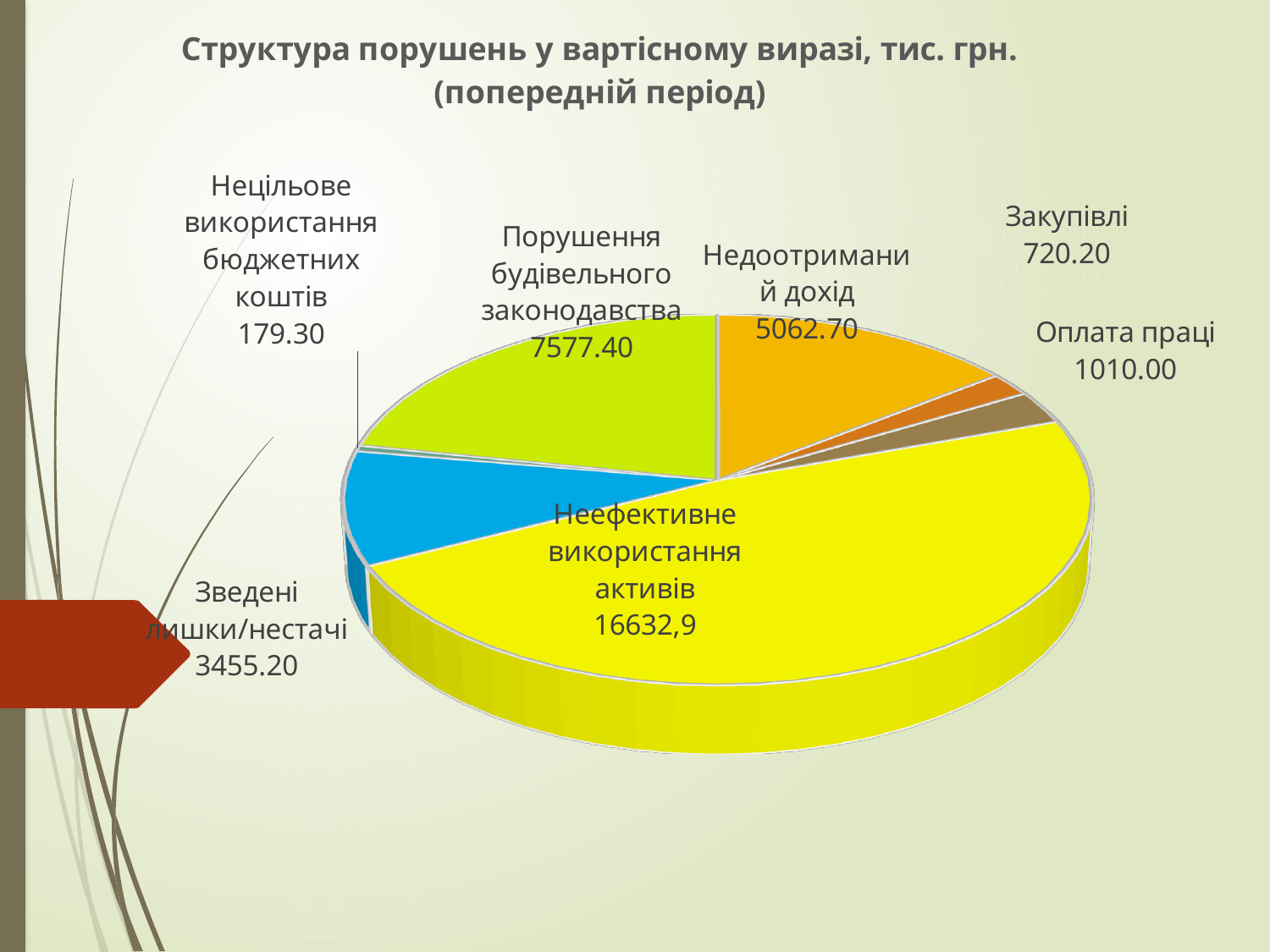
What is the difference between Оплата праці and Закупівлі? 289.80 How many categories does the pie chart show? 7 Which category has the smallest slice? Нецільове використання бюджетних коштів What is the value for Неефективне використання активів? 16632,9 What is the difference between Порушення будівельного законодавства and Недоотриманий дохід? 2514.70 What is the title of the chart? Структура порушень у вартісному виразі, тис. грн. (попередній період) What is the value for Недоотриманий дохід? 5062.70 Which is larger, Зведені лишки/нестачі or Закупівлі? Зведені лишки/нестачі Which category has the largest slice? Неефективне використання активів What kind of chart is shown on the slide? pie chart What is the value for Порушення будівельного законодавства? 7577.40 What is the value for Оплата праці? 1010.00